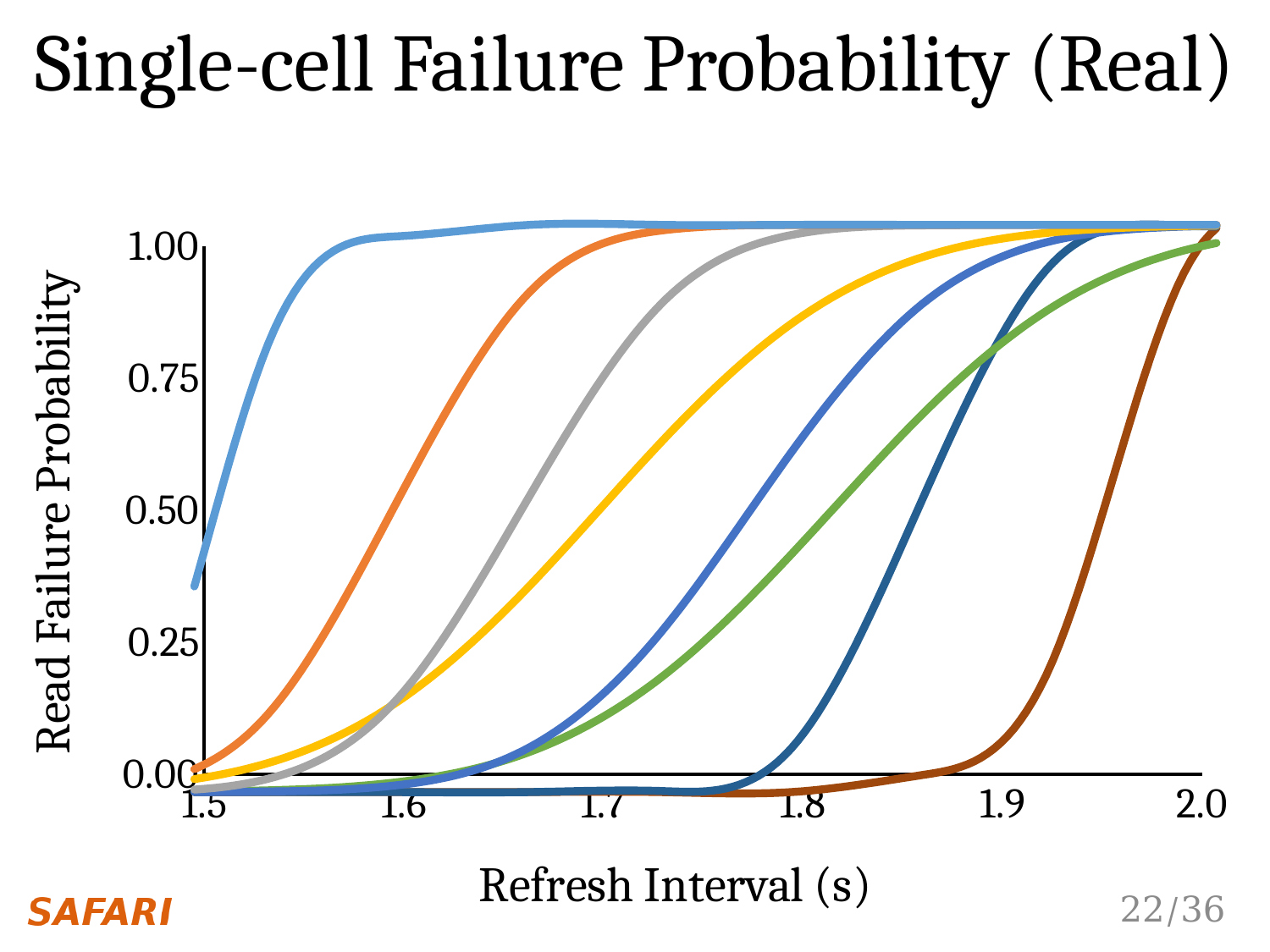
Is the value of the brown line at a refresh interval of 1.9 s greater or less than 0.25? less Is the value of the orange line at a refresh interval of 1.7 s greater or less than 0.75? greater Is the value of the dark blue line at a refresh interval of 1.8 s greater or less than 0.25? less At a refresh interval of 1.6 s, which line has the higher read failure probability, the light blue line or the brown line? light blue line What is the title of the chart on the slide? Single-cell Failure Probability (Real) What kind of chart is shown on the slide? line chart What is the label of the x axis? Refresh Interval (s) How many lines are plotted on the chart? 8 Do the plotted lines rise or fall as the refresh interval increases? rise